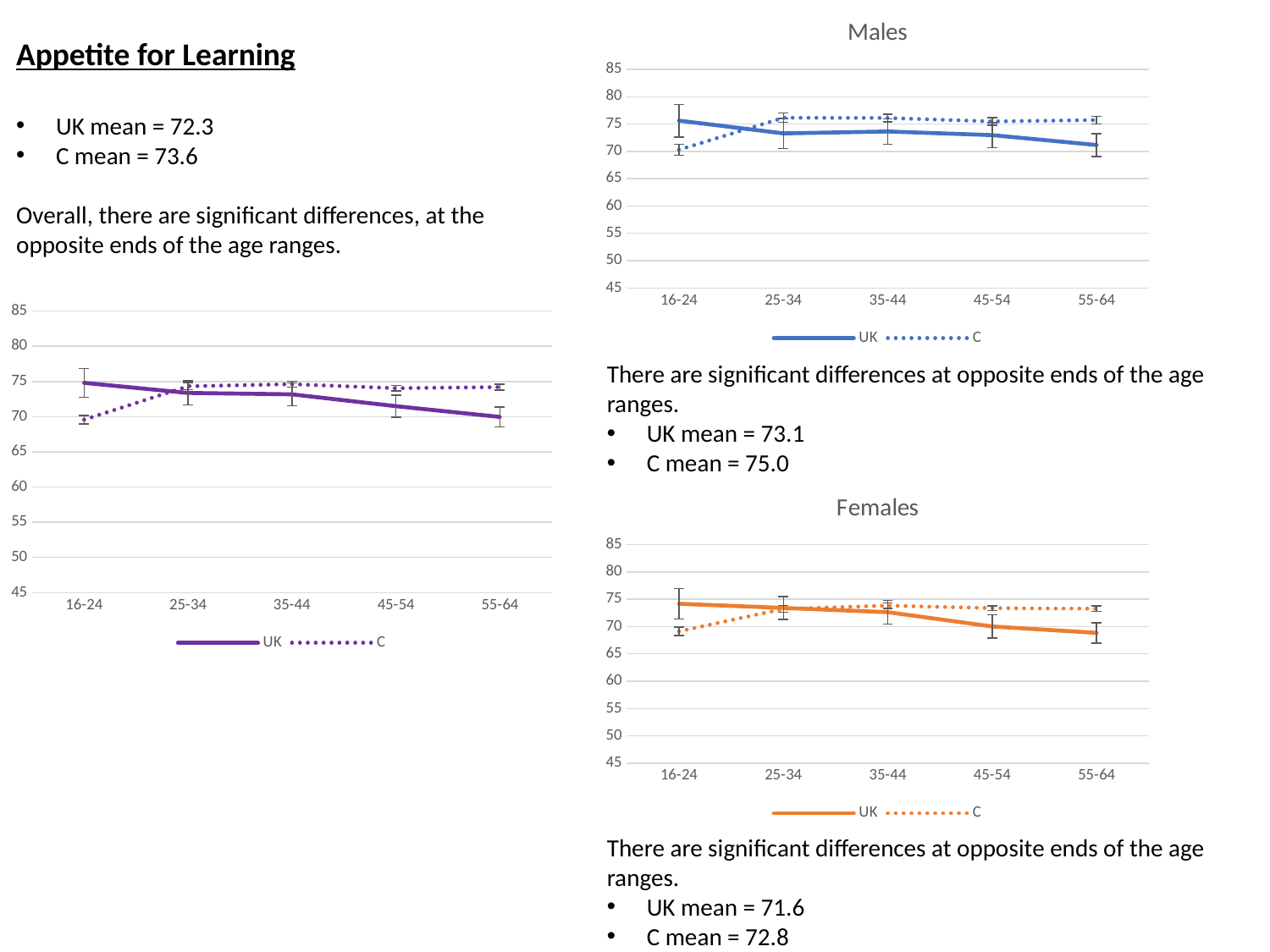
How many series does the legend of the chart on the left of the slide list? 2 In the 'Males' chart, which series has the larger value at 16-24, UK or C? UK In the 'Females' chart, does the UK series rise or fall from 16-24 to 55-64? fall What kind of chart is the 'Males' chart? line chart In the 'Males' chart, does the UK series rise or fall from 16-24 to 55-64? fall How many age categories are shown on the x axis of the 'Females' chart? 5 In the 'Females' chart, is the value for UK at 55-64 greater or less than 75? less In the 'Females' chart, at which age category is the C series lowest? 16-24 In the 'Males' chart, which series has the larger value at 55-64, UK or C? C In the chart on the left of the slide, is the value for UK at 55-64 greater or less than 65? greater What is the title of the chart at the top right of the slide? Males In the 'Females' chart, which series has the larger value at 16-24, UK or C? UK